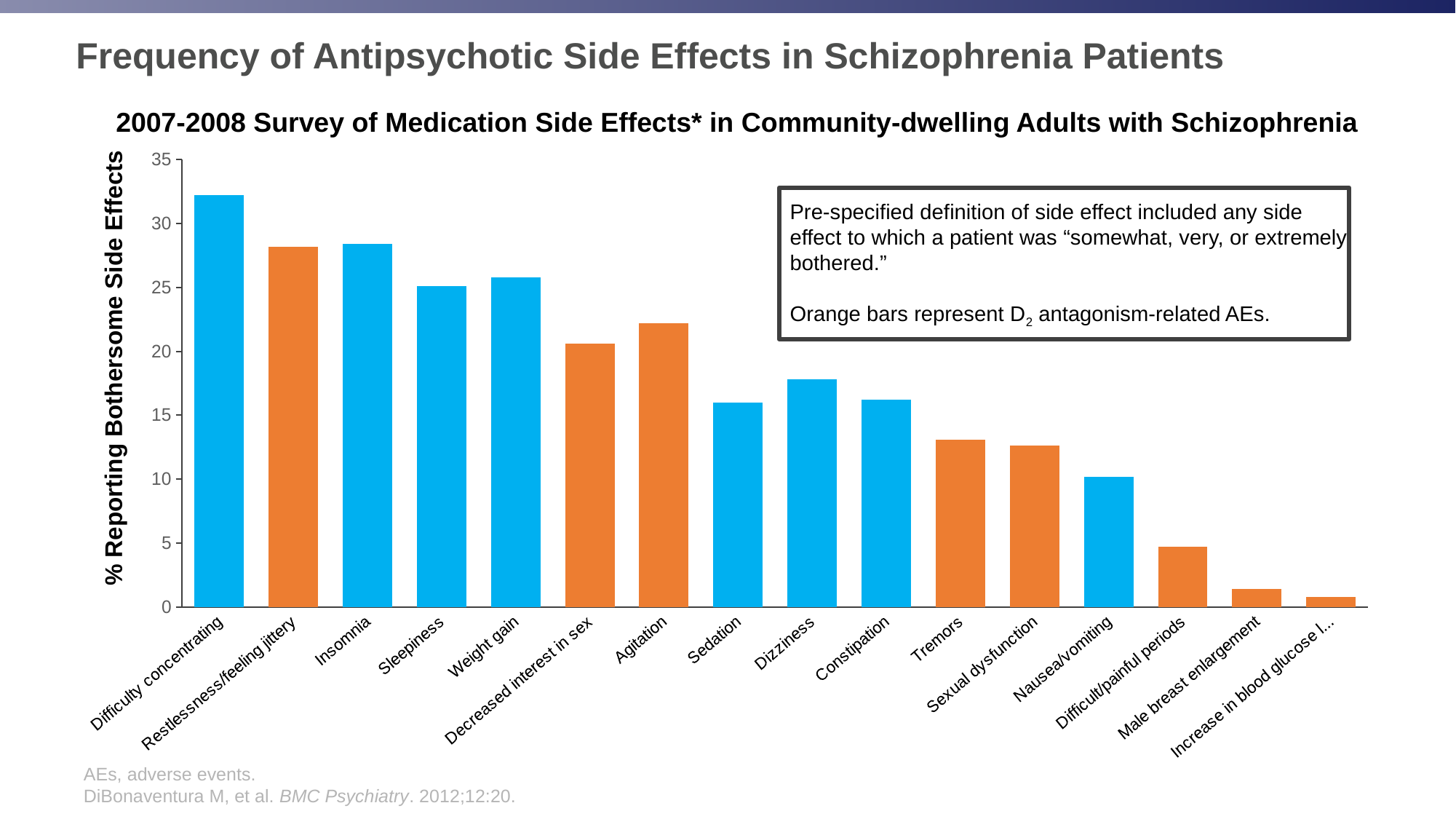
Is the value for Agitation greater or less than 20? greater Is the value for Difficulty concentrating greater or less than 30? greater Is the value for Tremors greater or less than 15? less What kind of chart is shown on the slide? Bar chart Which is larger, the value for Agitation or the value for Decreased interest in sex? Agitation Do the bar values generally rise or fall from left to right across the chart? fall Which is larger, the value for Dizziness or the value for Sedation? Dizziness According to the text box, what do the orange bars represent? D2 antagonism-related AEs Which side effect has the highest percentage of patients reporting it as bothersome? Difficulty concentrating How many side-effect categories are plotted on the chart? 16